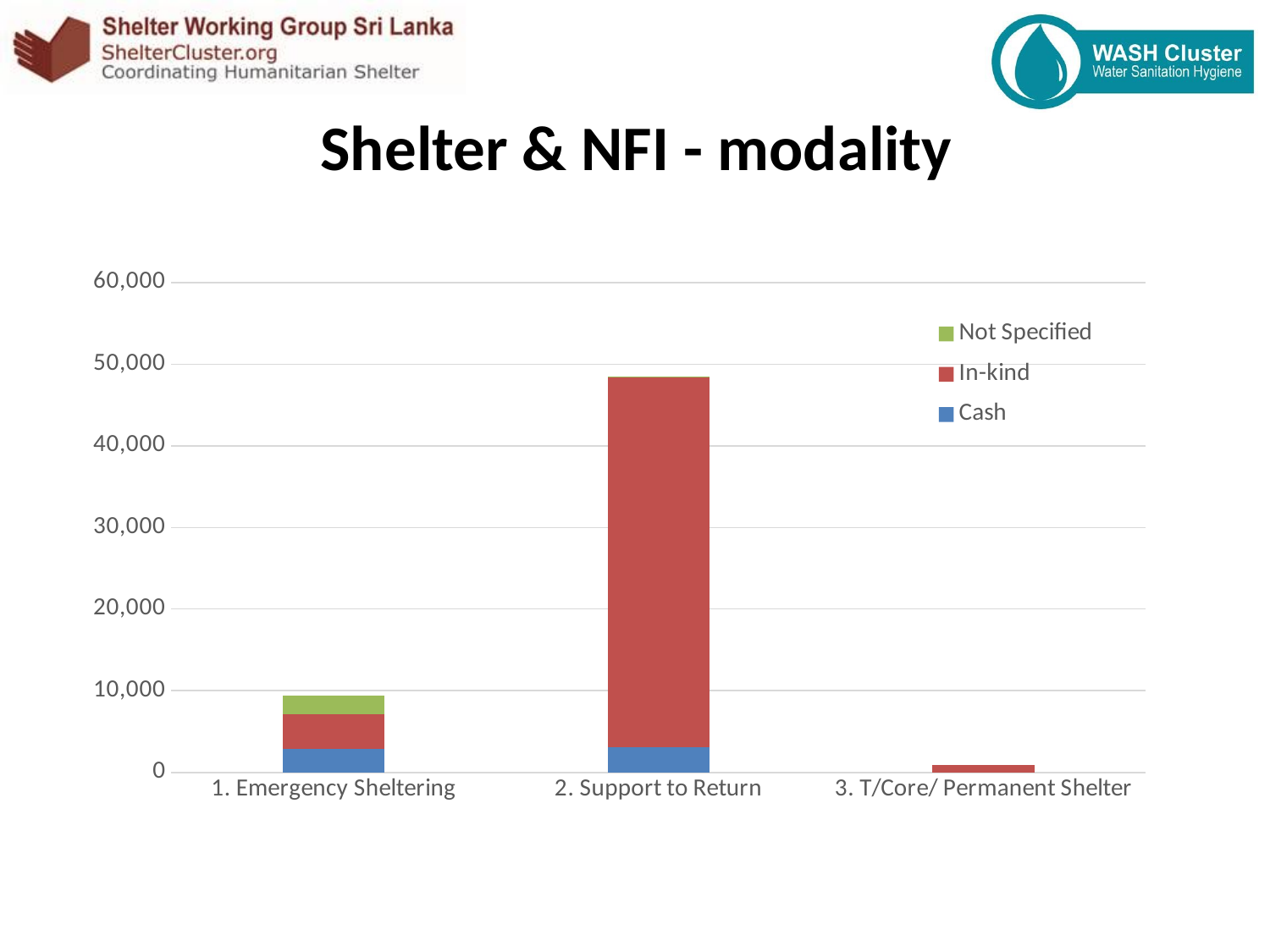
Is the total stacked value for 2. Support to Return greater or less than 40,000? greater Is the total stacked value for 1. Emergency Sheltering greater or less than 10,000? less How many categories are shown on the x axis? 3 Which series makes up most of the bar for 2. Support to Return? In-kind Is the value for 3. T/Core/ Permanent Shelter greater or less than 10,000? less What is the title of the chart? Shelter & NFI - modality Which category is the only one with a visible Not Specified segment? 1. Emergency Sheltering Which is larger, the stacked bar for 1. Emergency Sheltering or the stacked bar for 3. T/Core/ Permanent Shelter? 1. Emergency Sheltering What kind of chart is shown on the slide? stacked bar chart Which category has the shortest stacked bar? 3. T/Core/ Permanent Shelter Which category has the tallest stacked bar? 2. Support to Return How many series does the legend list? 3